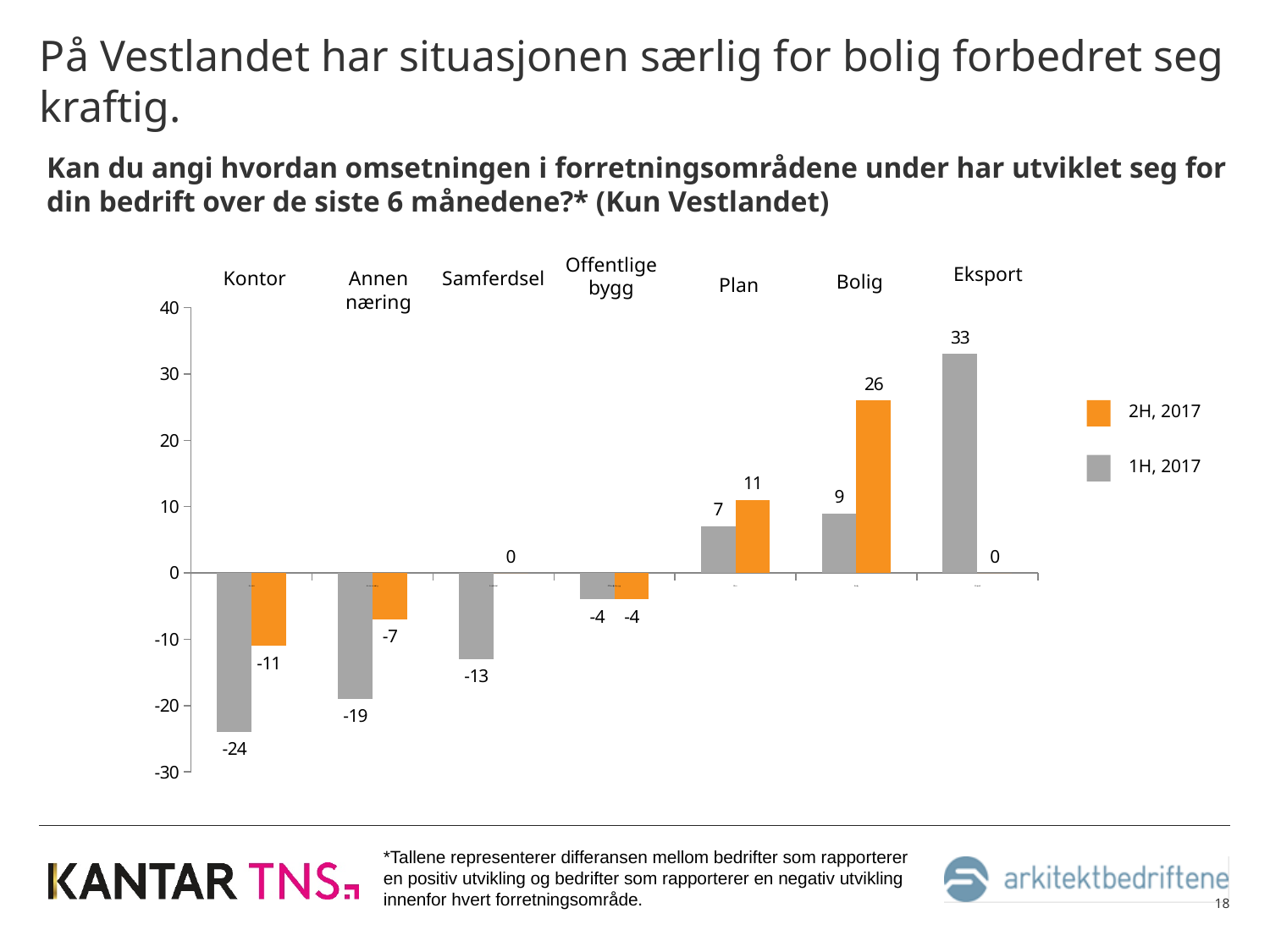
Which category has the highest value in the 1H, 2017 series? Eksport How many categories are shown on the x axis? 7 How many series does the legend list? 2 What is the value for Bolig in the 2H, 2017 series? 26 Which is larger for Annen næring: the 1H, 2017 value or the 2H, 2017 value? 2H, 2017 What is the difference between the 2H, 2017 and 1H, 2017 values for Bolig? 17 Which colour represents the 2H, 2017 series in the legend? Orange What is the value for Samferdsel in the 1H, 2017 series? -13 Which category has the lowest value in the 2H, 2017 series? Kontor What is the value for Plan in the 2H, 2017 series? 11 What kind of chart is shown on the slide? Bar chart What is the value for Kontor in the 1H, 2017 series? -24